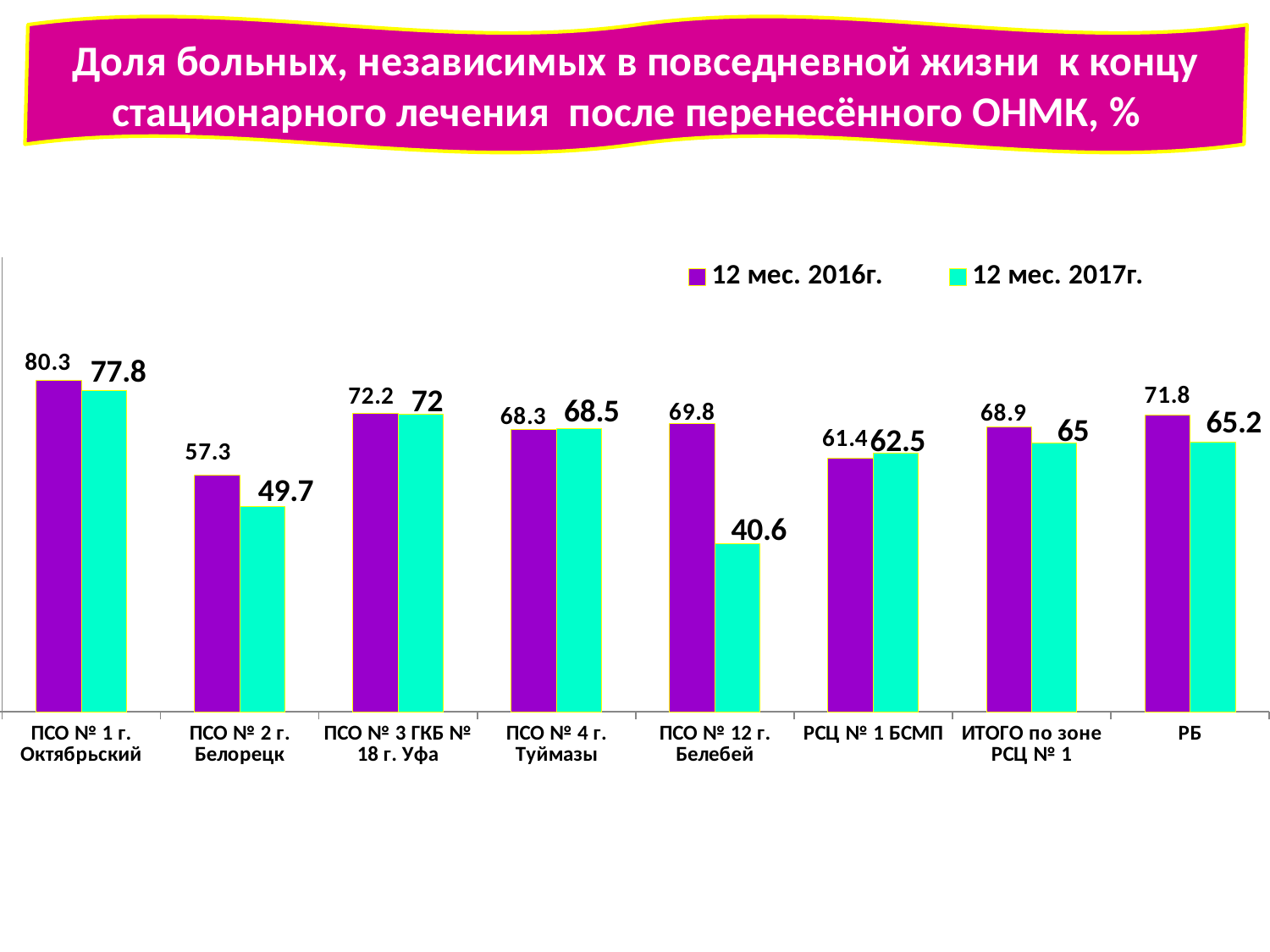
What is the value for ПСО № 1 г. Октябрьский in the 12 мес. 2016г. series? 80.3 How many series does the legend list? 2 Which category has the lowest value in the 12 мес. 2017г. series? ПСО № 12 г. Белебей What kind of chart is shown on the slide? bar chart What is the value for ПСО № 12 г. Белебей in the 12 мес. 2017г. series? 40.6 For РСЦ № 1 БСМП, which series has the larger value: 12 мес. 2016г. or 12 мес. 2017г.? 12 мес. 2017г. How many categories are shown on the x axis? 8 Which colour represents the 12 мес. 2017г. series? cyan What is the difference between the 12 мес. 2016г. and 12 мес. 2017г. values for ПСО № 12 г. Белебей? 29.2 What is the difference between the 12 мес. 2016г. and 12 мес. 2017г. values for ПСО № 2 г. Белорецк? 7.6 What is the value for РБ in the 12 мес. 2017г. series? 65.2 Which category has the highest value in the 12 мес. 2016г. series? ПСО № 1 г. Октябрьский